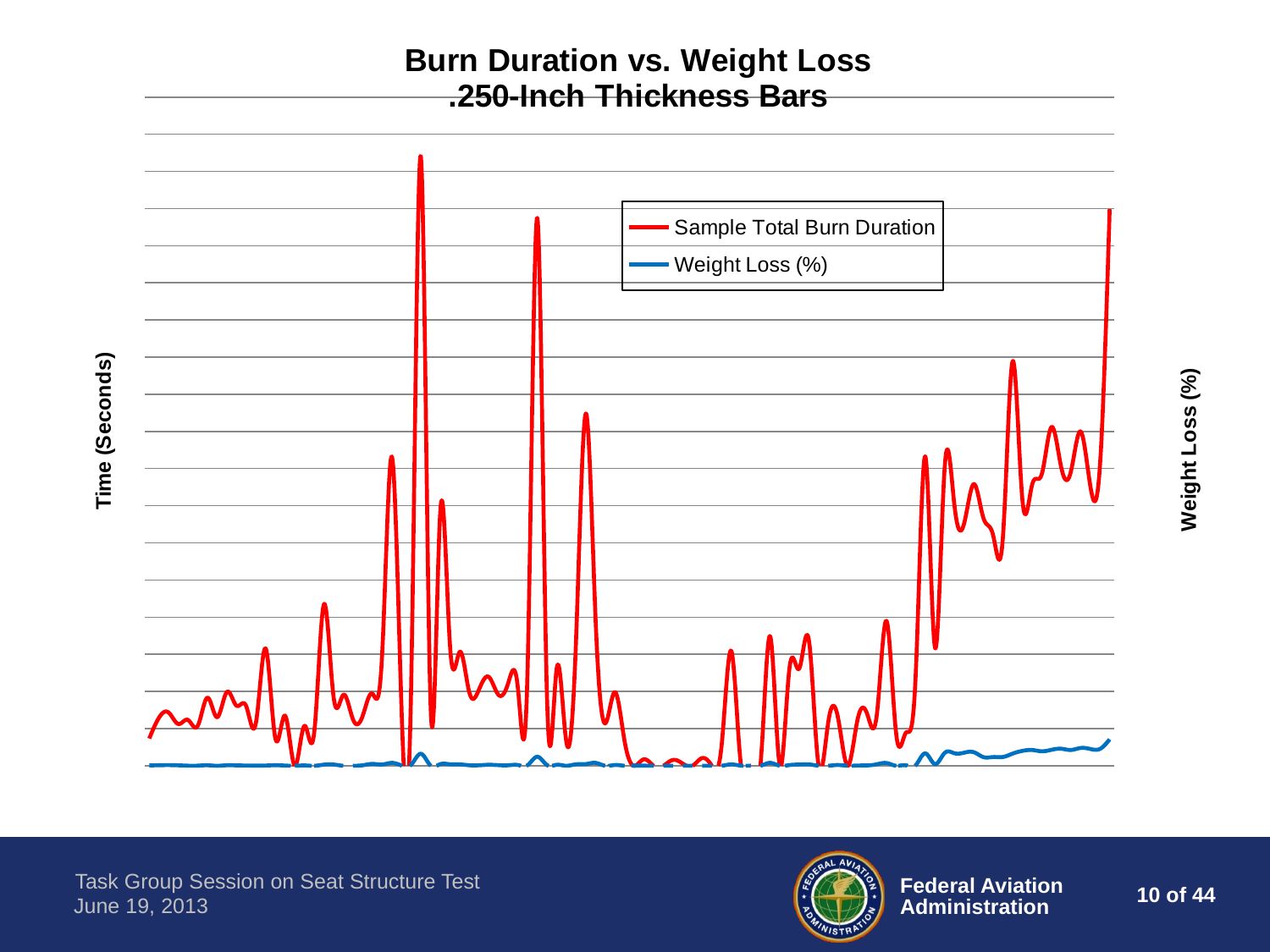
What is the title of the left vertical axis? Time (Seconds) How many series does the legend list? 2 What kind of chart is shown on the slide? line chart Which series is plotted higher on the chart overall, Sample Total Burn Duration or Weight Loss (%)? Sample Total Burn Duration Does the Weight Loss (%) line rise or fall at the far right end of the chart? rise What are the two series named in the legend? Sample Total Burn Duration and Weight Loss (%)